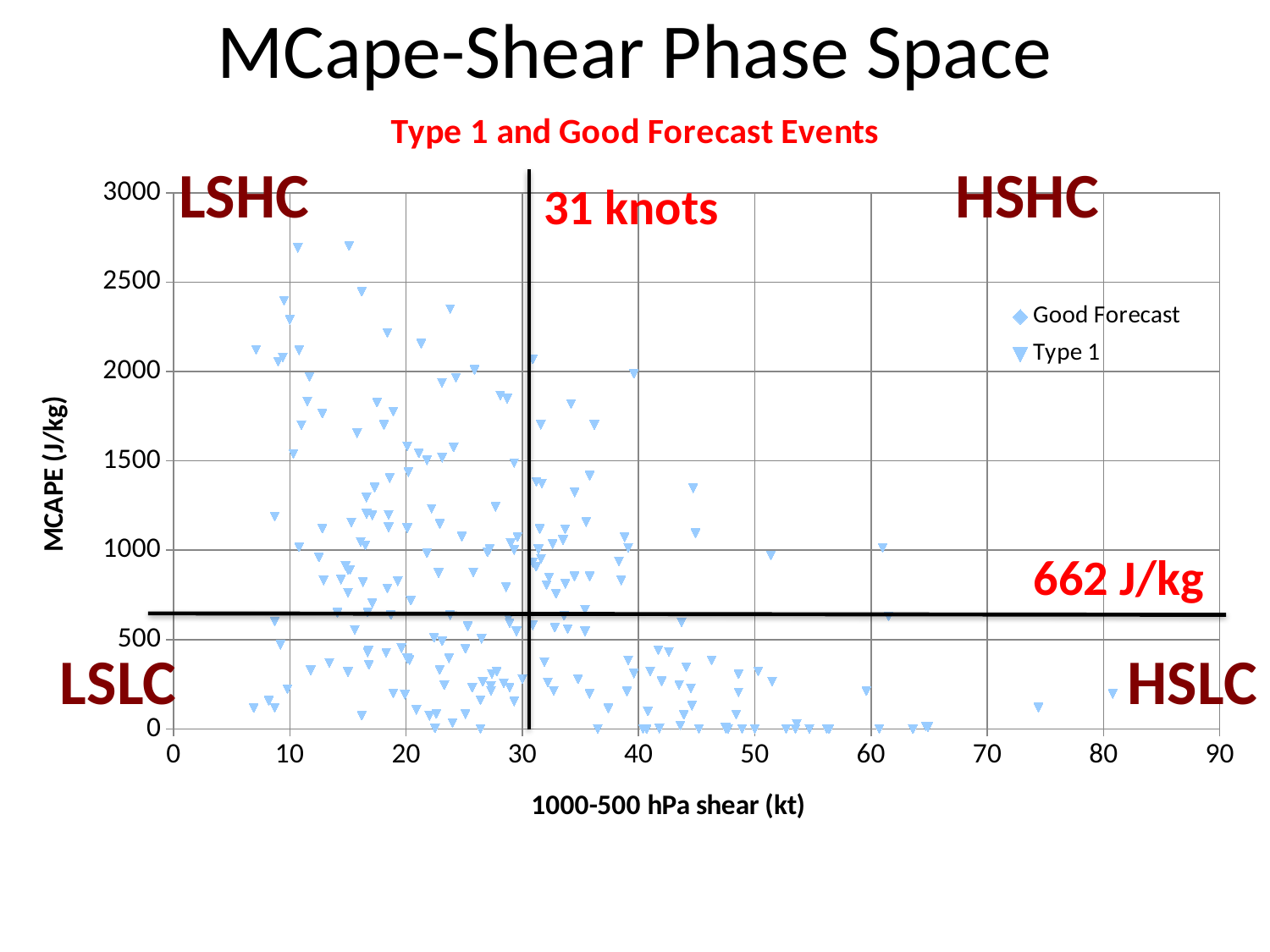
What shear value does the vertical reference line mark, according to the label on the chart? 31 knots What MCAPE value does the horizontal reference line mark, according to the label on the chart? 662 J/kg What kind of chart is shown on the slide? scatter chart What is the maximum value shown on the y axis? 3000 Is the highest MCAPE value plotted greater or less than 2500? greater What is the maximum value shown on the x axis? 90 Is the largest shear value plotted greater or less than 70? greater How many series does the legend list? 2 What are the two series named in the legend? Good Forecast and Type 1 What is the title of the chart? Type 1 and Good Forecast Events